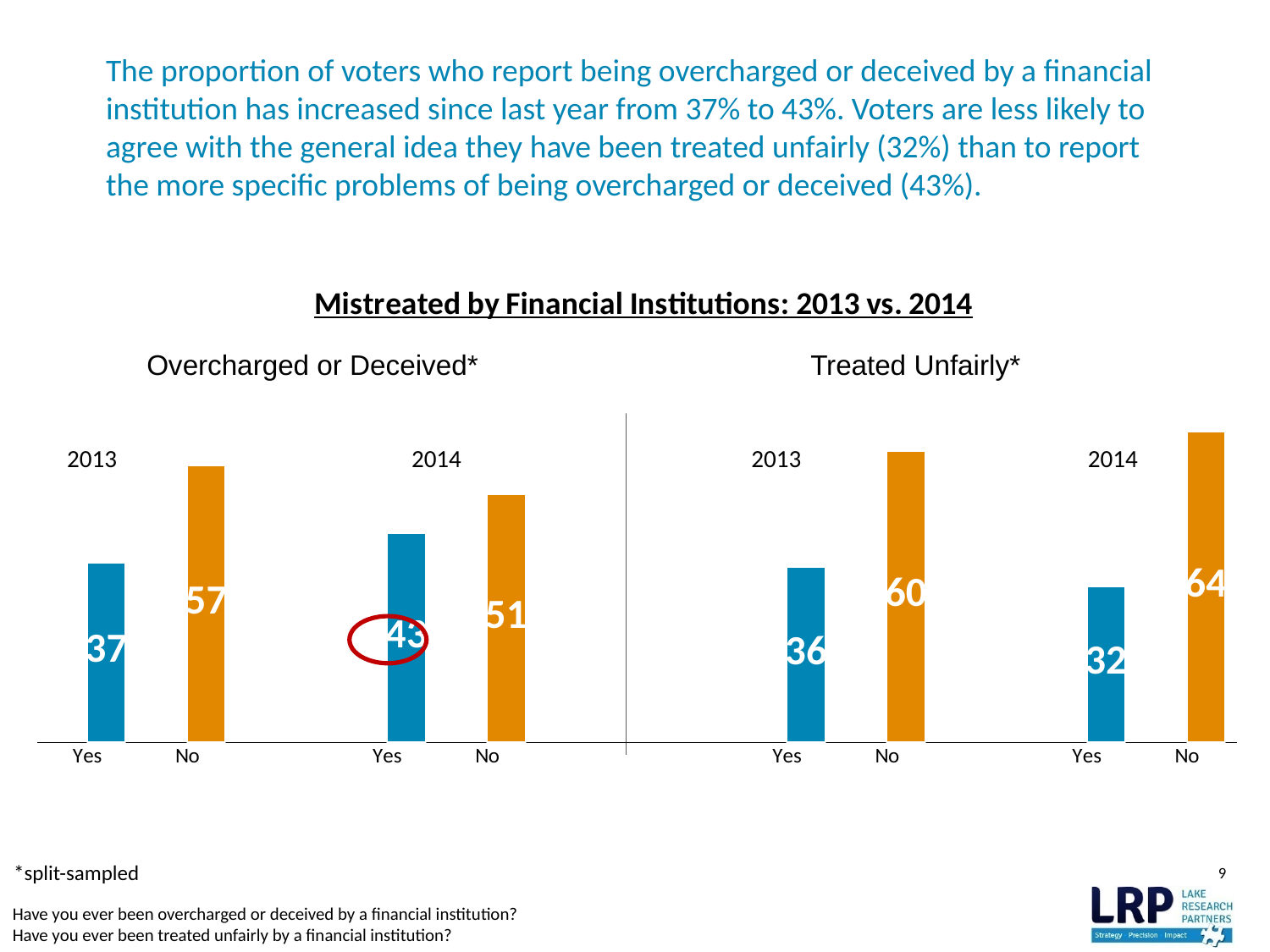
In the Overcharged or Deceived chart, which value is circled in red? 43 In the Treated Unfairly chart, which bar is the lowest? Yes, 2014 In the Overcharged or Deceived chart, what is the value for Yes in 2013? 37 In the Overcharged or Deceived chart, which bar is the highest? No, 2013 In the Treated Unfairly chart, what is the difference between No and Yes in 2014? 32 In the Overcharged or Deceived chart, how does the Yes value change from 2013 to 2014? It rises In the Treated Unfairly chart, what is the value for No in 2013? 60 In the Treated Unfairly chart, which is larger: Yes in 2013 or Yes in 2014? Yes in 2013 In the Overcharged or Deceived chart, what is the difference between the Yes values for 2014 and 2013? 6 What type of chart is used on this slide? Bar chart In the Overcharged or Deceived chart, what is the value for No in 2014? 51 In the Treated Unfairly chart, what is the value for Yes in 2014? 32